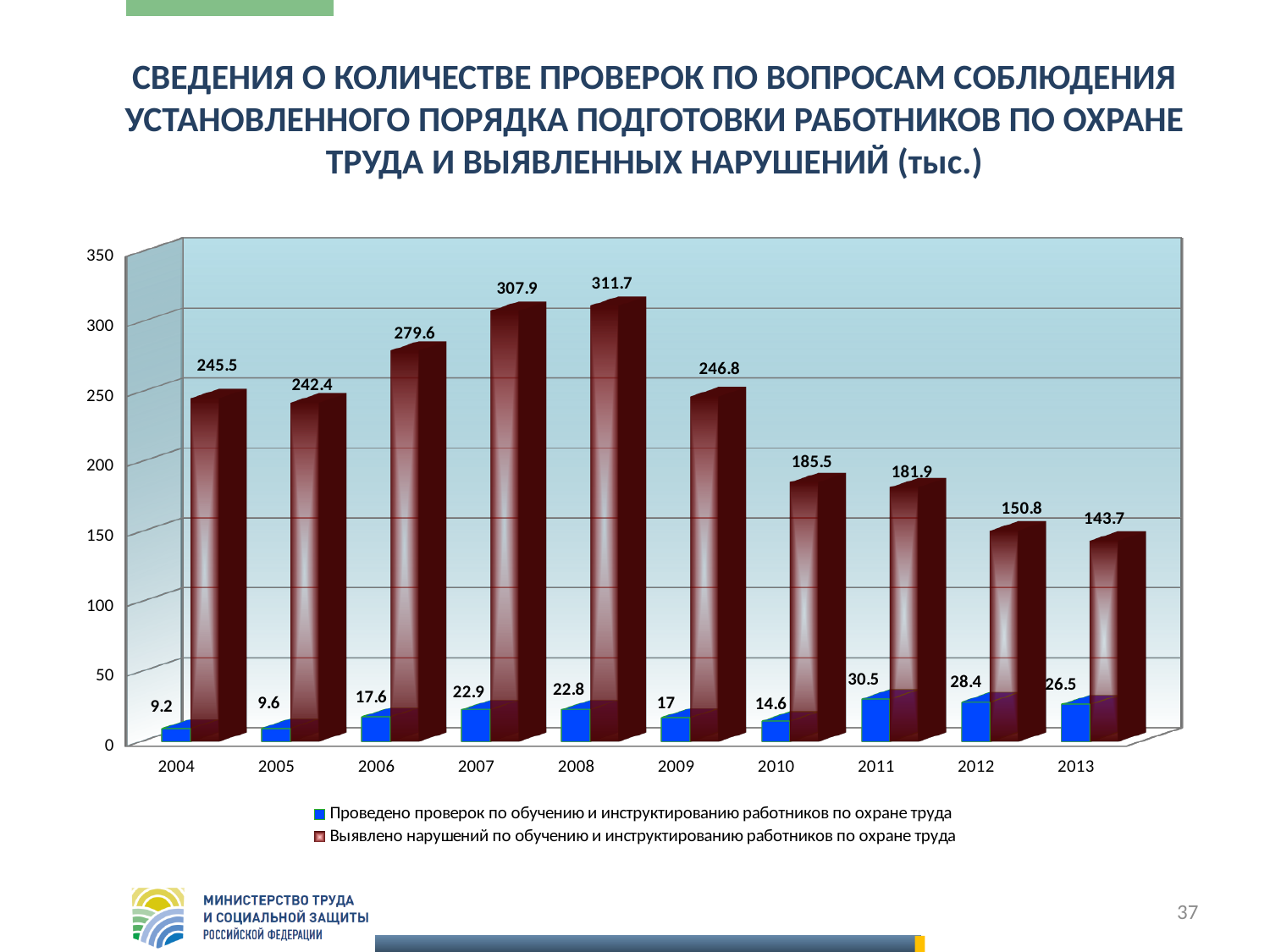
What kind of chart is shown on the slide? bar chart How many series does the legend list? 2 In which year is 'Проведено проверок по обучению и инструктированию работников по охране труда' lowest? 2004 Which is larger: 'Проведено проверок' in 2006 or in 2009? 2006 What is the value of 'Выявлено нарушений по обучению и инструктированию работников по охране труда' for 2013? 143.7 What is the difference between the 'Выявлено нарушений' values for 2007 and 2013? 164.2 What is the value of 'Выявлено нарушений по обучению и инструктированию работников по охране труда' for 2008? 311.7 Does 'Выявлено нарушений по обучению и инструктированию работников по охране труда' rise or fall from 2008 to 2013? fall What is the value of 'Проведено проверок по обучению и инструктированию работников по охране труда' for 2011? 30.5 In which year is 'Выявлено нарушений по обучению и инструктированию работников по охране труда' highest? 2008 Is the value of 'Выявлено нарушений' for 2010 greater or less than 200? less How many years are shown on the x axis? 10